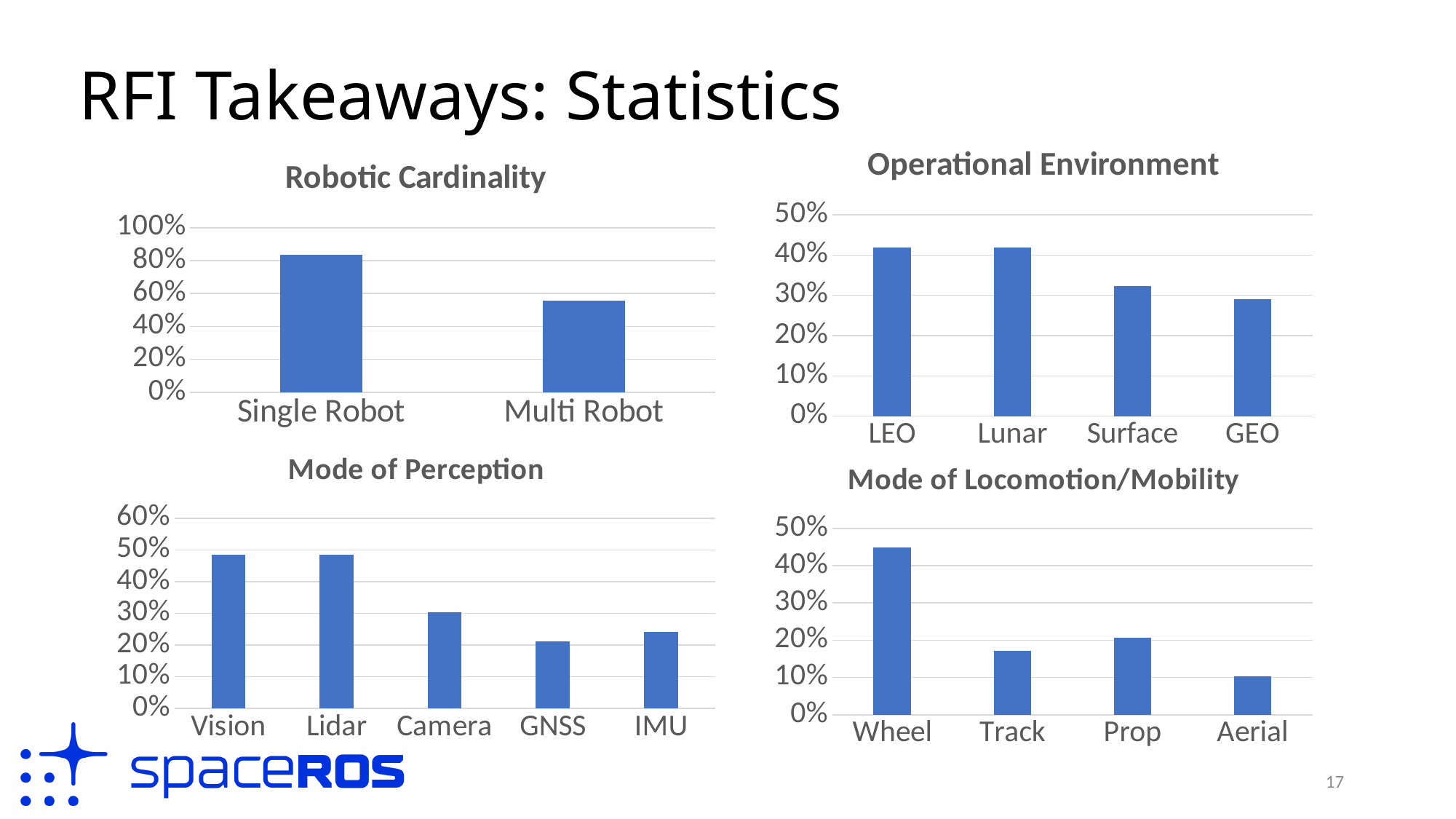
In the Mode of Locomotion/Mobility chart, which category has the highest value? Wheel In the Mode of Perception chart, is the value for Camera greater or less than 40%? less How many categories are shown in the Mode of Perception chart? 5 In the Robotic Cardinality chart, which category has the higher value? Single Robot In the Operational Environment chart, which is larger, Lunar or GEO? Lunar What kind of chart is the Mode of Locomotion/Mobility chart? Bar chart How many categories are shown in the Operational Environment chart? 4 In the Robotic Cardinality chart, is the value for Single Robot greater or less than 80%? greater In the Mode of Locomotion/Mobility chart, which category has the lowest value? Aerial In the Robotic Cardinality chart, is the value for Multi Robot greater or less than 60%? less In the Mode of Perception chart, which is larger, Vision or GNSS? Vision